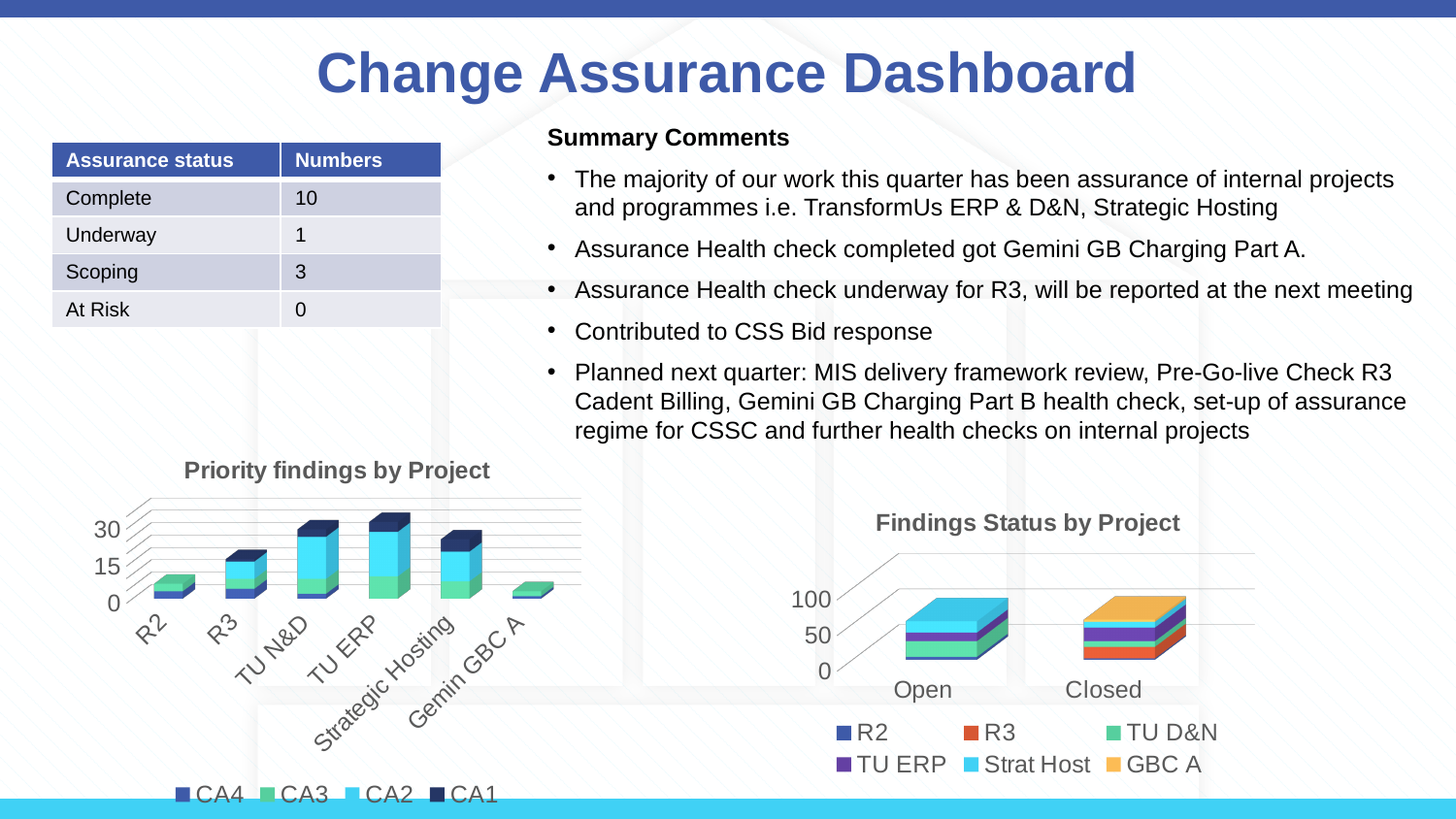
In the "Priority findings by Project" chart, is the total for Strategic Hosting greater or less than 15? greater What kind of chart is "Findings Status by Project"? bar chart In the "Priority findings by Project" chart, is the total for TU ERP greater or less than 15? greater How many projects are shown on the x axis of the "Priority findings by Project" chart? 6 What kind of chart is "Priority findings by Project"? bar chart How many categories are shown on the x axis of the "Findings Status by Project" chart? 2 In the "Findings Status by Project" chart, is the total for Open greater or less than 50? greater In the "Priority findings by Project" chart, which has the larger total, Strategic Hosting or Gemin GBC A? Strategic Hosting How many series does the legend of the "Findings Status by Project" chart list? 6 How many series does the legend of the "Priority findings by Project" chart list? 4 In the "Priority findings by Project" chart, which has the larger total, TU ERP or R3? TU ERP